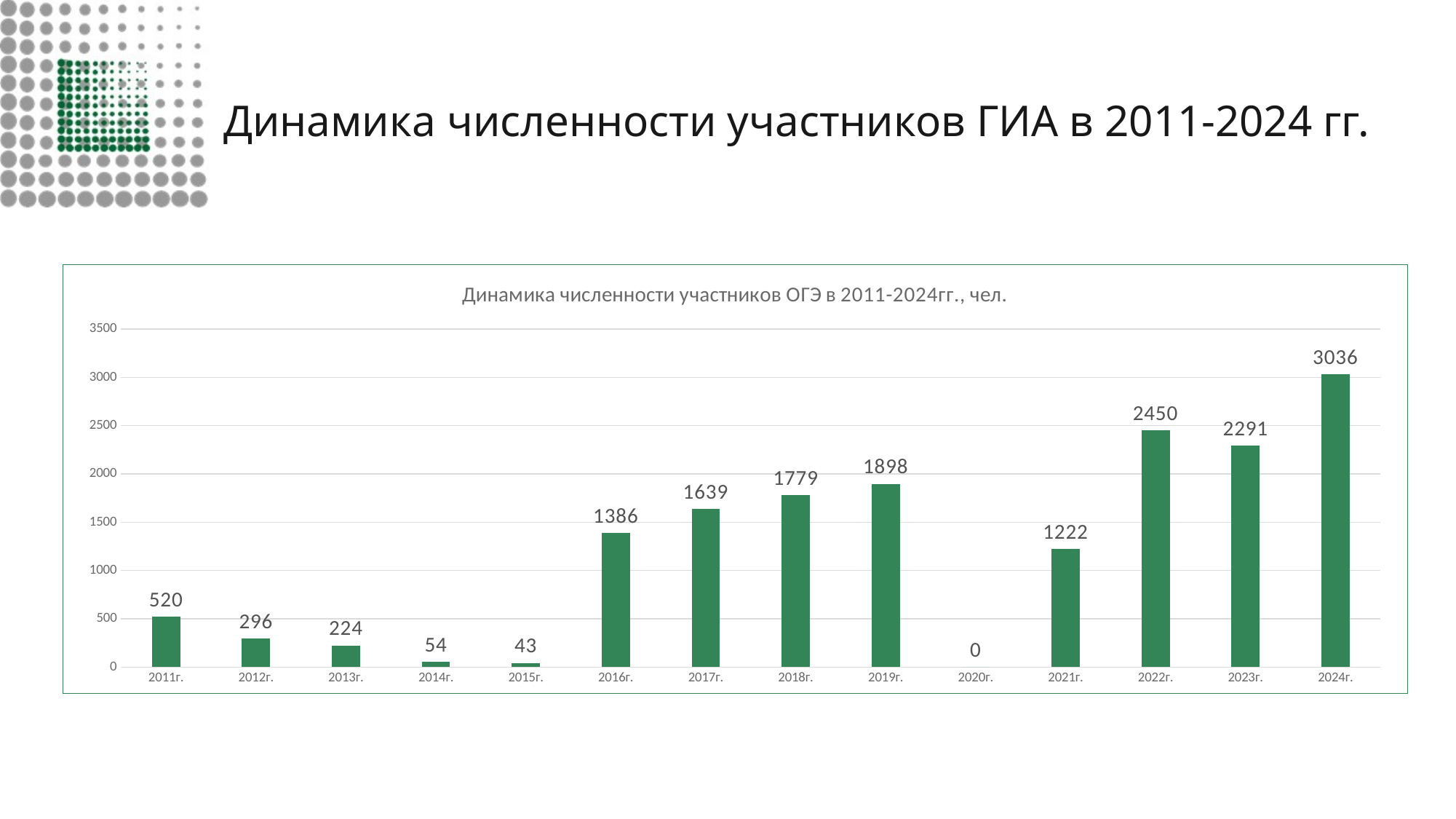
What is the value for 2014г.? 54 What is the value for 2021г.? 1222 What kind of chart is this? bar chart What is the title of the chart? Динамика численности участников ОГЭ в 2011-2024гг., чел. Is the value for 2019г. greater or less than 2000? less Do the values rise or fall from 2011г. to 2015г.? fall Which year has the highest value? 2024г. Which year has the lowest value? 2020г. How many years are shown on the x axis? 14 What is the value for 2016г.? 1386 What is the difference between the values for 2024г. and 2023г.? 745 Which is larger, the value for 2022г. or the value for 2023г.? 2022г.